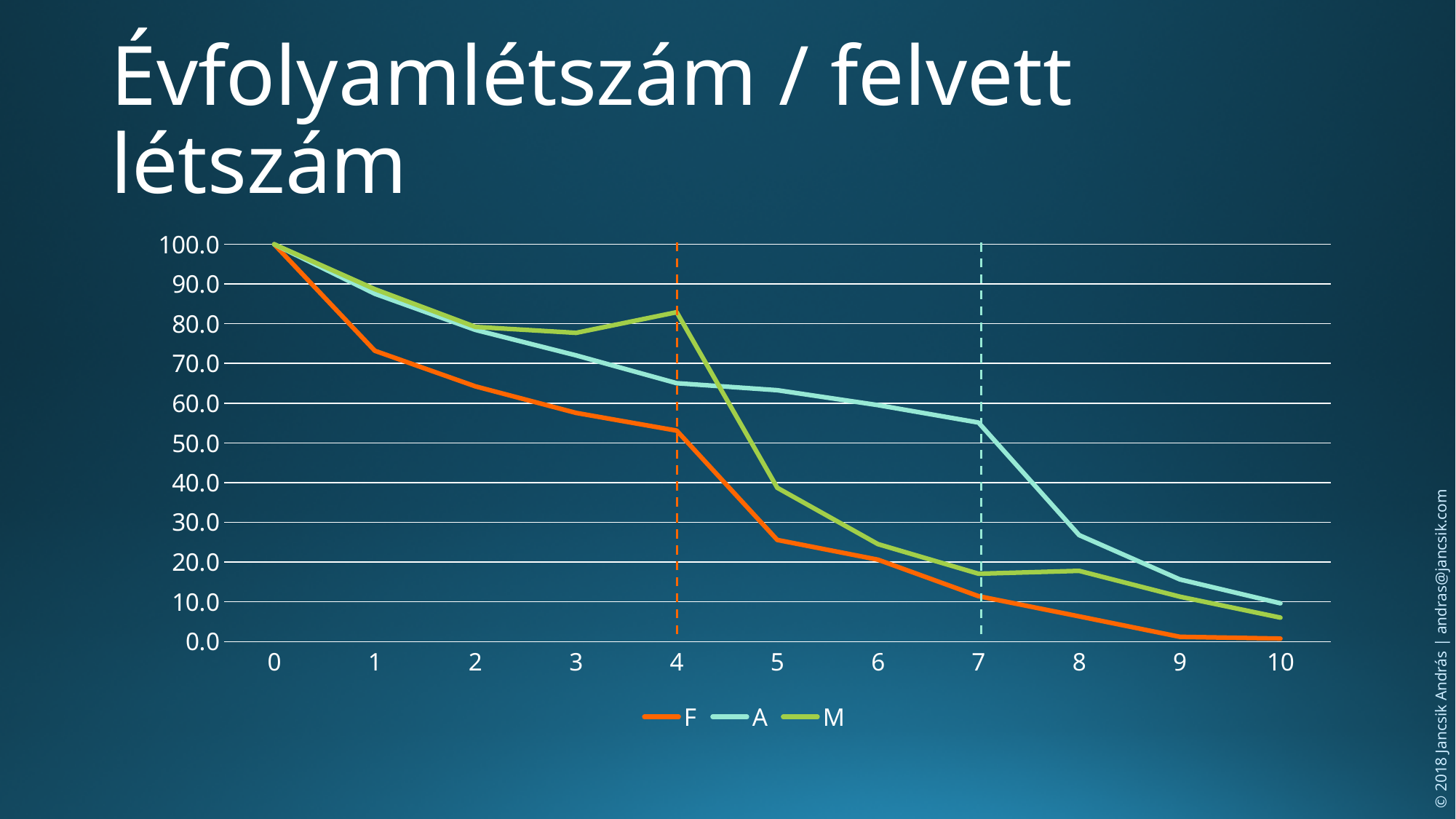
Is the value for series F at x = 9 greater or less than 10? less How many series does the legend list? 3 Is the value for series M at x = 4 greater or less than 80? greater Is the value for series A at x = 8 greater or less than 20? greater At x = 8, which series has the highest value? A What is the value of series F at x = 0? 100.0 At x = 5, which series has the larger value, A or M? A How many points are marked along the x axis? 11 Do the values of series F rise or fall as x increases from 0 to 10? fall What kind of chart is shown on the slide? line chart At x = 10, which series has the lowest value? F